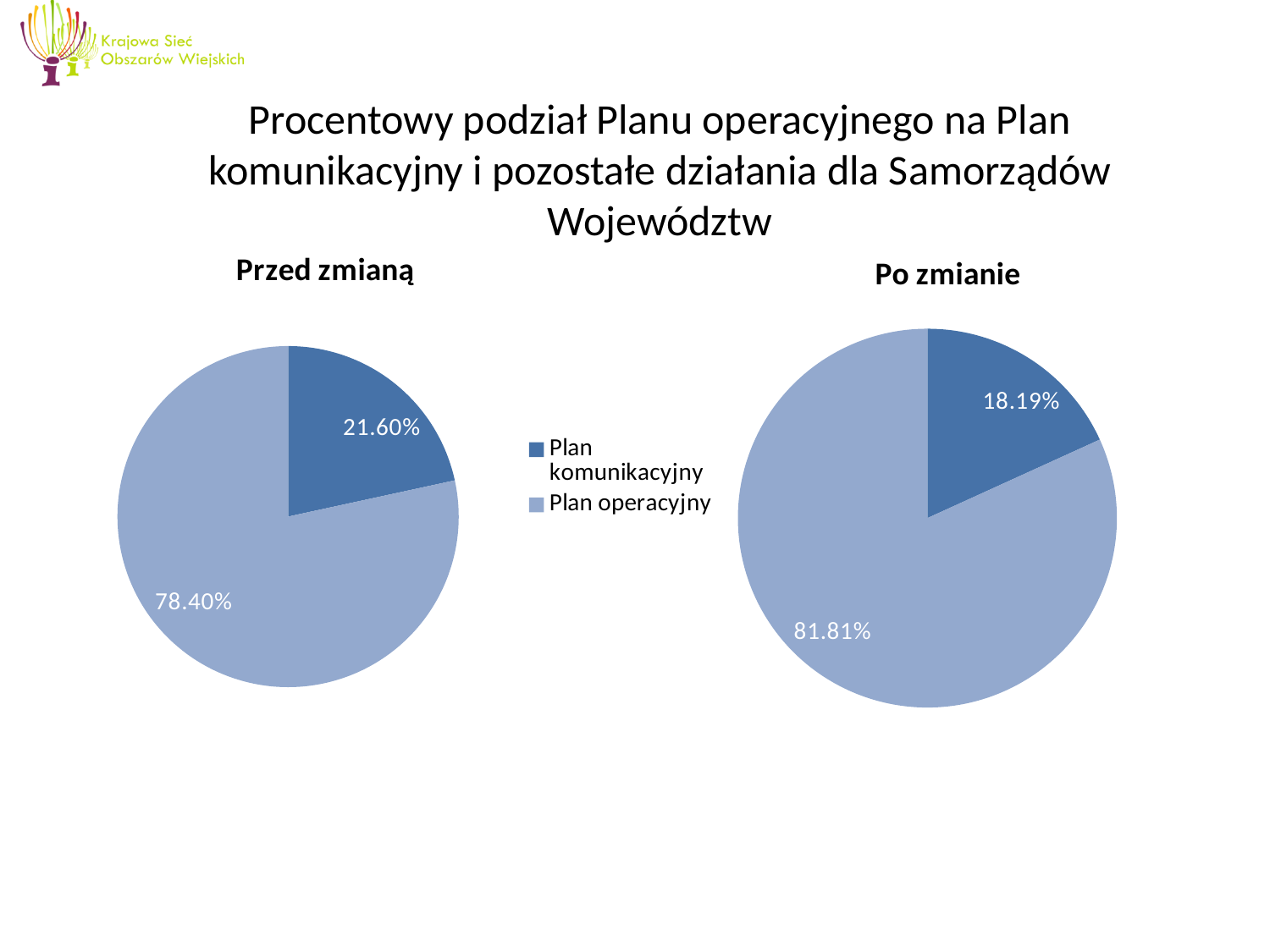
In the 'Po zmianie' pie chart, what is the share for Plan komunikacyjny? 18.19% Is the Plan komunikacyjny share larger in the 'Przed zmianą' chart or in the 'Po zmianie' chart? Przed zmianą In the 'Po zmianie' pie chart, what is the share for Plan operacyjny? 81.81% In the 'Po zmianie' pie chart, which slice is the smallest? Plan komunikacyjny In the 'Przed zmianą' pie chart, which slice is the largest? Plan operacyjny In the 'Przed zmianą' pie chart, what is the share for Plan komunikacyjny? 21.60% How many entries does the legend list? 2 What type of chart is used for 'Przed zmianą' and 'Po zmianie'? Pie chart What is the difference between the Plan komunikacyjny share in the 'Przed zmianą' chart and in the 'Po zmianie' chart? 3.41% Which legend entry is shown in the darker blue colour? Plan komunikacyjny In the 'Przed zmianą' pie chart, what is the share for Plan operacyjny? 78.40% How many slices does the 'Po zmianie' pie chart have? 2